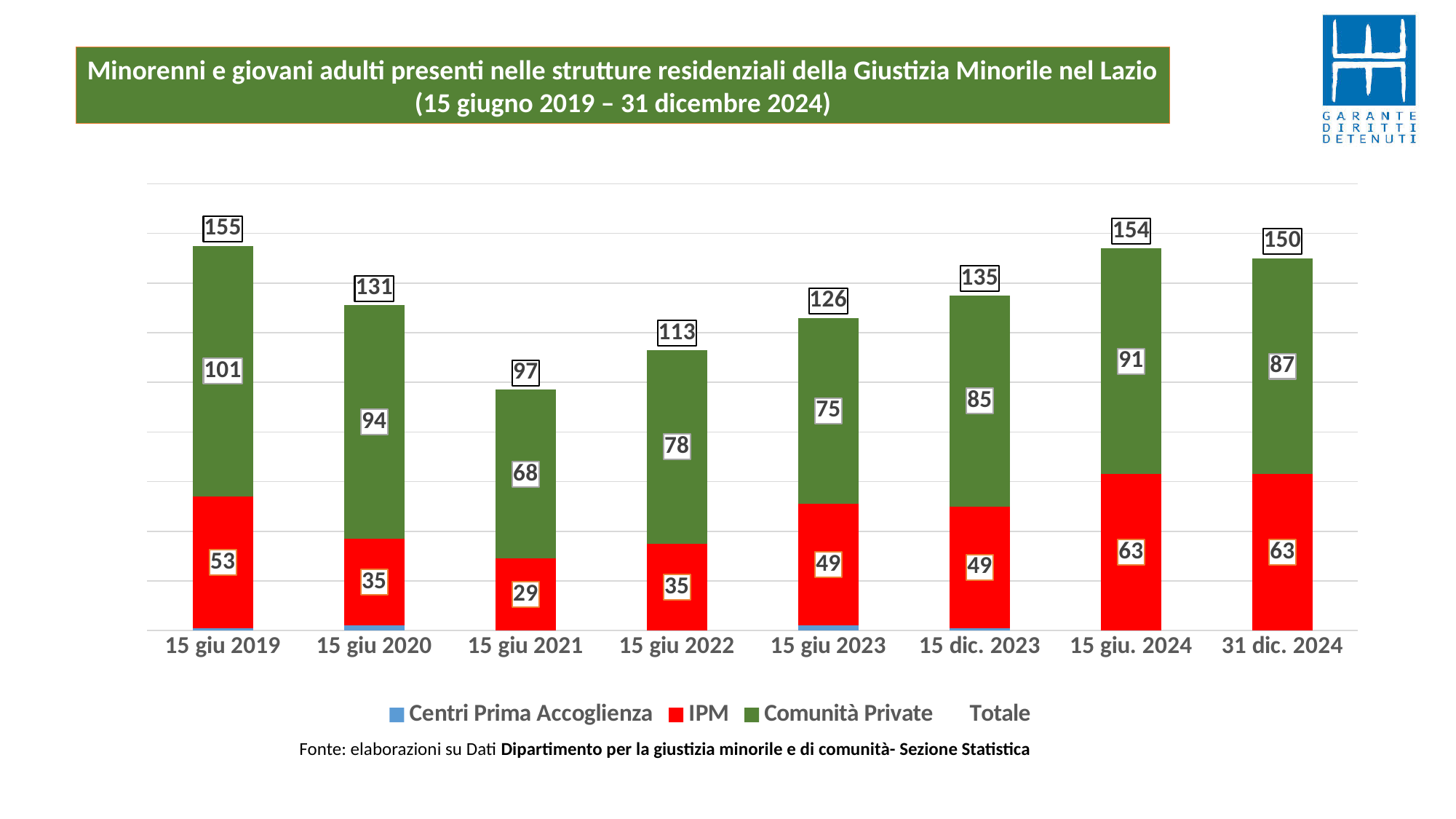
What is the total shown above the bar for 15 dic. 2023? 135 What is the Comunità Private value for 15 giu 2021? 68 What is the difference between the Comunità Private values for 15 giu 2019 and 15 giu 2021? 33 Which date has the lowest total? 15 giu 2021 What is the IPM value for 15 giu 2019? 53 Which is larger, the IPM value for 15 giu 2023 or for 15 giu 2022? 15 giu 2023 How many dates are shown on the x axis? 8 What kind of chart is shown? Stacked bar chart Which date has the highest total? 15 giu 2019 Do the totals rise or fall from 15 giu 2021 to 15 giu. 2024? Rise What colour represents IPM in the chart? Red How many series does the legend list? 4